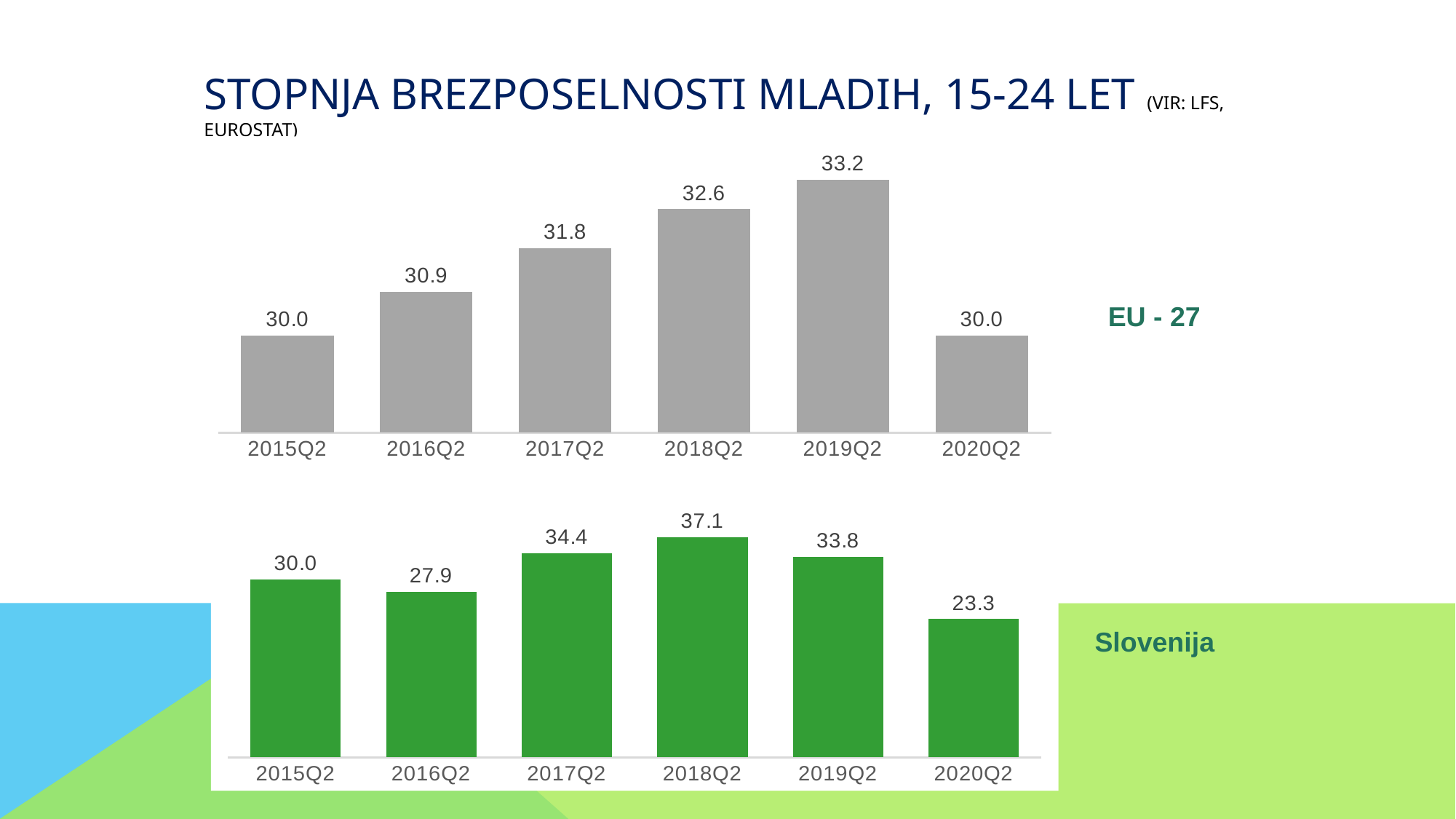
In the EU - 27 chart (top), which quarter has the highest value? 2019Q2 In the Slovenija chart (bottom), what is the difference between the values for 2018Q2 and 2020Q2? 13.8 Which is larger: the 2017Q2 value in the EU - 27 chart (top) or the 2017Q2 value in the Slovenija chart (bottom)? Slovenija chart (34.4) What kind of chart is the Slovenija chart (bottom)? Bar chart In the Slovenija chart (bottom), which quarter has the highest value? 2018Q2 In the Slovenija chart (bottom), what is the value for 2020Q2? 23.3 In the Slovenija chart (bottom), which quarter has the lowest value? 2020Q2 In the EU - 27 chart (top), what is the difference between the values for 2019Q2 and 2015Q2? 3.2 What colour are the bars in the Slovenija chart (bottom)? Green How many quarters are shown in the EU - 27 chart (top)? 6 In the EU - 27 chart (top), do the values rise or fall from 2015Q2 to 2019Q2? Rise In the EU - 27 chart (top), what is the value for 2019Q2? 33.2